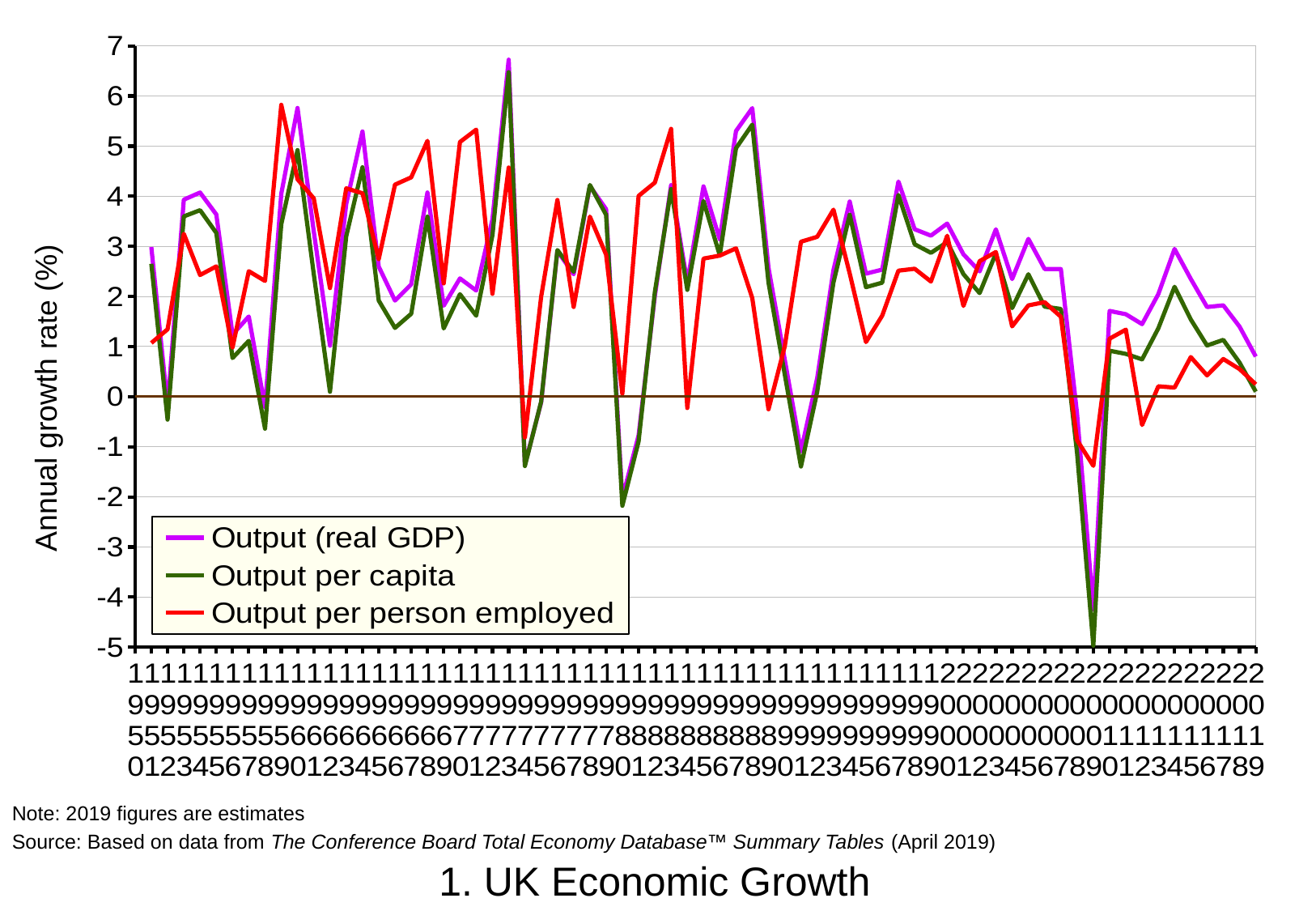
In 1973, which series has the higher value: Output (real GDP) or Output per person employed? Output (real GDP) In which year does the Output (real GDP) series reach its highest value? 1973 Is the value for Output per person employed in 1959 greater or less than 5? greater Is the value for Output (real GDP) in 1973 greater or less than 6? greater What is the title of the chart? 1. UK Economic Growth How many series does the legend list? 3 In which year does the Output per person employed series reach its highest value? 1959 What kind of chart is shown on the slide? Line chart Is the value for Output per capita in 2009 greater or less than -4? less What is the label on the vertical axis? Annual growth rate (%) In 2009, which series has the lower value: Output per capita or Output per person employed? Output per capita In which year does the Output per capita series reach its lowest value? 2009